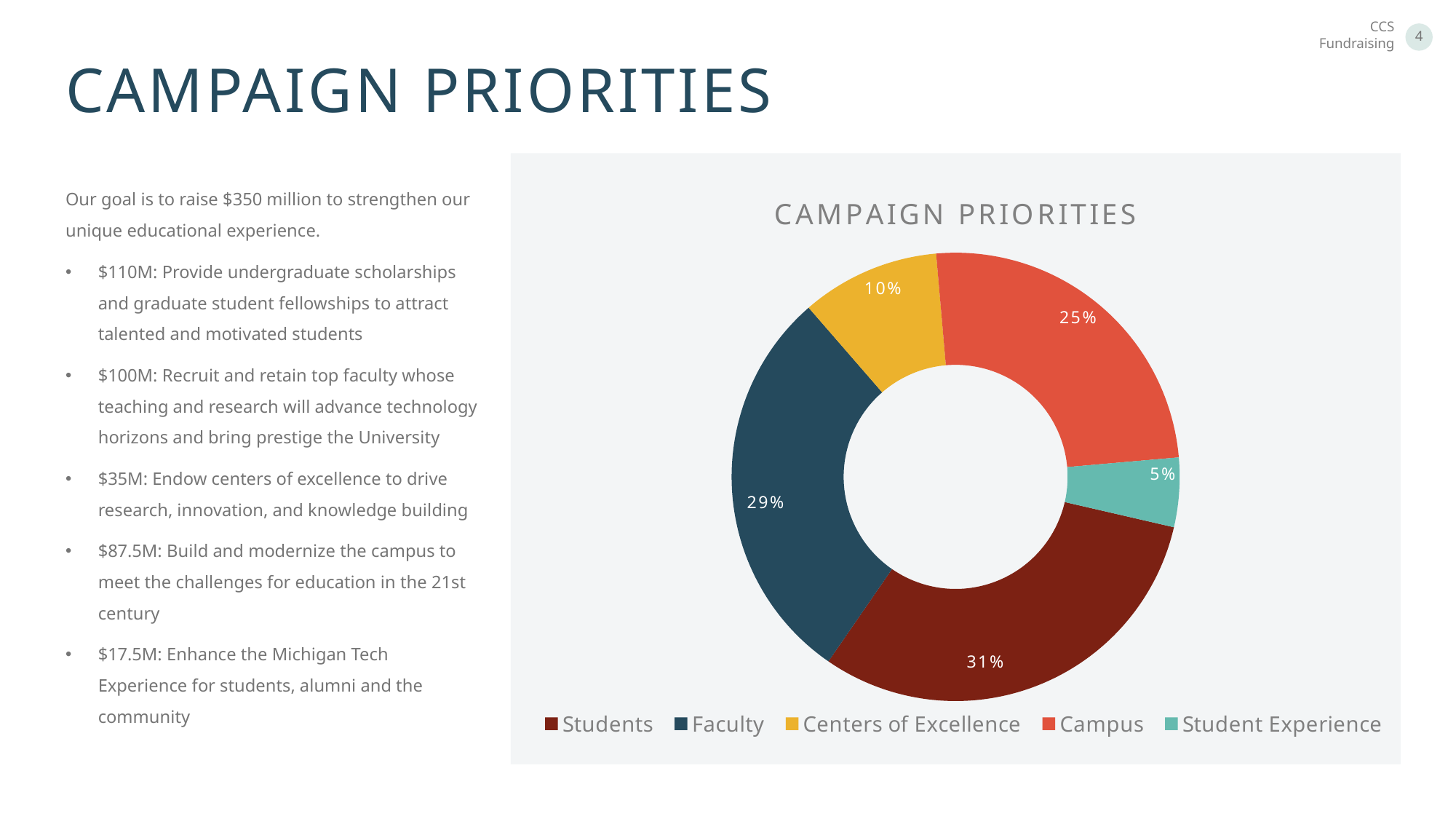
What share of the Campaign Priorities chart is Faculty? 29% Which category has the largest share in the Campaign Priorities chart? Students What colour is the Centers of Excellence slice? Yellow How many categories does the Campaign Priorities chart show? 5 What share of the Campaign Priorities chart is Centers of Excellence? 10% What share of the Campaign Priorities chart is Campus? 25% What is the difference in percentage points between the Campus and Centers of Excellence shares? 15 What share of the Campaign Priorities chart is Students? 31% Which category has the smallest share in the Campaign Priorities chart? Student Experience What share of the Campaign Priorities chart is Student Experience? 5% What kind of chart is shown on the slide? Doughnut (pie) chart Which has a larger share, Faculty or Campus? Faculty